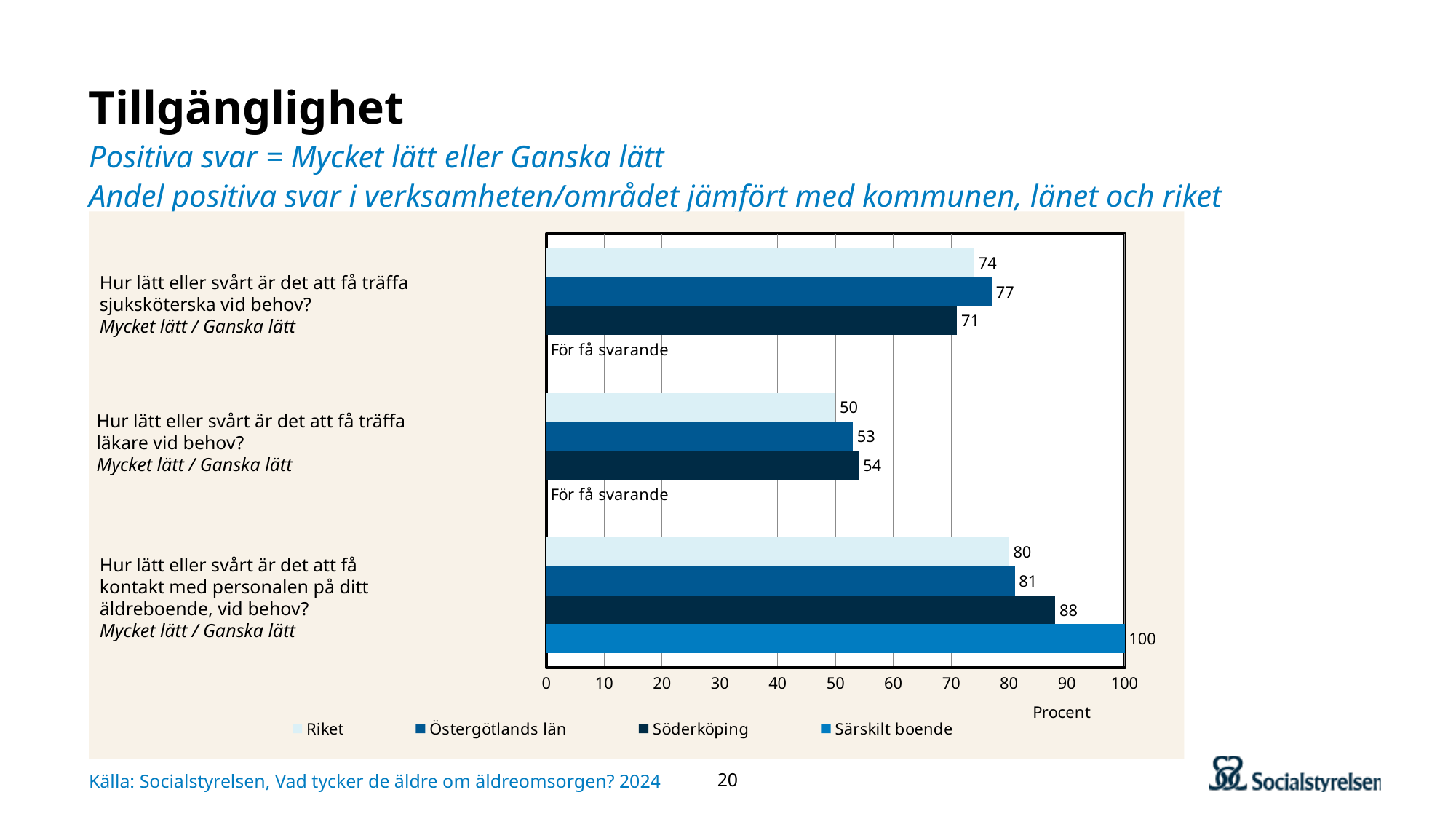
Which series has the lowest value on the question about meeting a nurse (sjuksköterska) when needed? Söderköping What kind of chart is shown on the slide? Bar chart What is shown for Särskilt boende on the question about meeting a nurse (sjuksköterska) when needed? För få svarande Which is larger on the question about meeting a doctor (läkare): Östergötlands län or Riket? Östergötlands län What is the value for Särskilt boende on the question about getting in contact with staff at the care home (kontakt med personalen)? 100 What is the value for Riket on the question about how easy it is to meet a nurse (sjuksköterska) when needed? 74 Which series has the highest value on the question about getting in contact with staff at the care home? Särskilt boende What is the difference between Söderköping and Riket on the question about getting in contact with staff at the care home? 8 How many question categories are shown on the chart? 3 What is the value for Söderköping on the question about how easy it is to meet a doctor (läkare) when needed? 54 What unit is labelled on the horizontal axis of the chart? Procent How many series does the legend list? 4